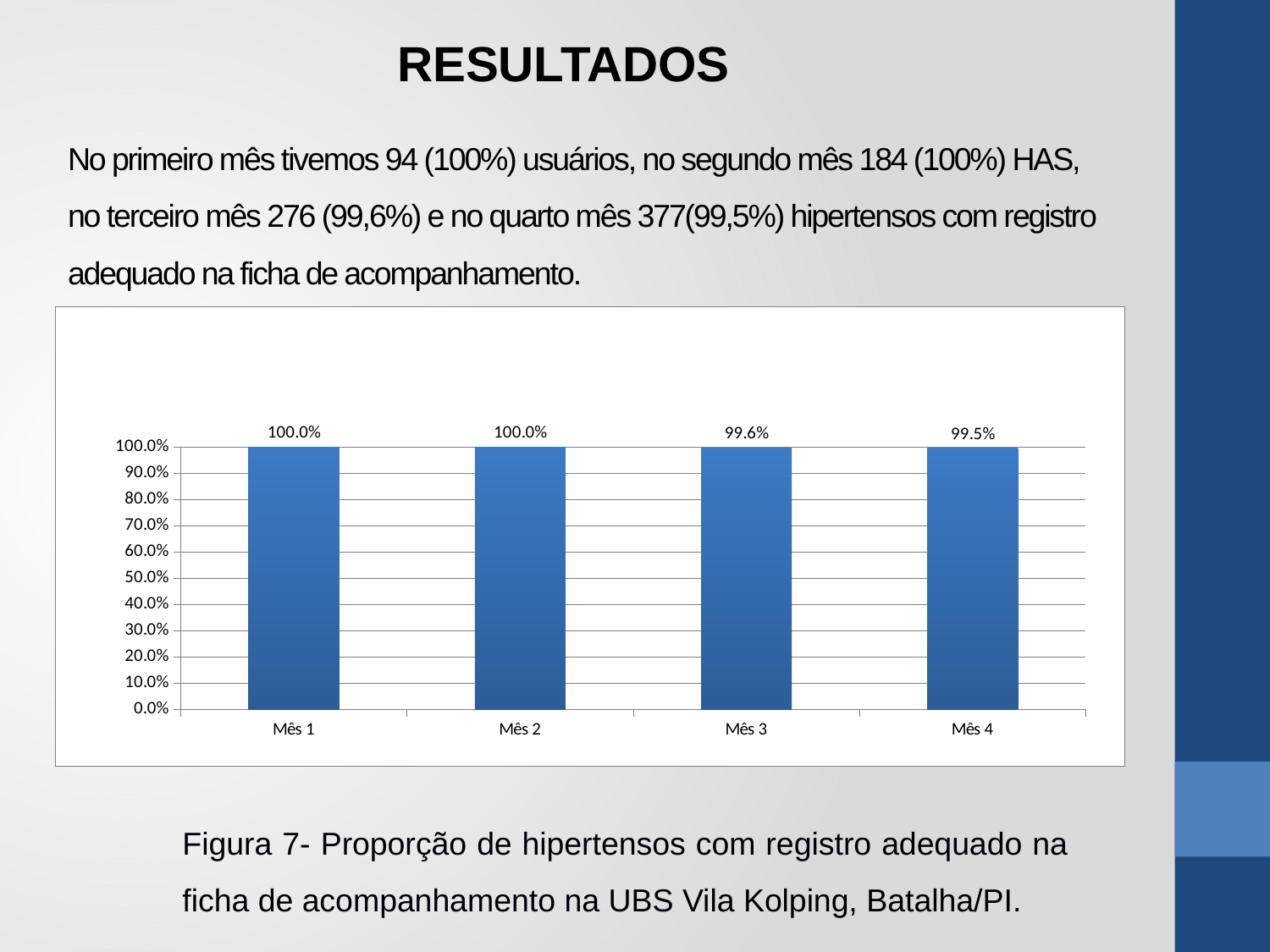
What colour are the bars in the chart? blue How many months are shown on the x axis? 4 What is the value for Mês 3? 99.6% Which is larger, the value for Mês 3 or the value for Mês 4? Mês 3 Is the value for Mês 2 greater or less than 50.0%? greater Do the values rise or fall from Mês 1 to Mês 4? fall Which month has the lowest value? Mês 4 What is the difference between the values for Mês 3 and Mês 4? 0.1% What is the value for Mês 1? 100.0% What kind of chart is shown on the slide? bar chart What is the value for Mês 4? 99.5% What is the difference between the values for Mês 1 and Mês 4? 0.5%